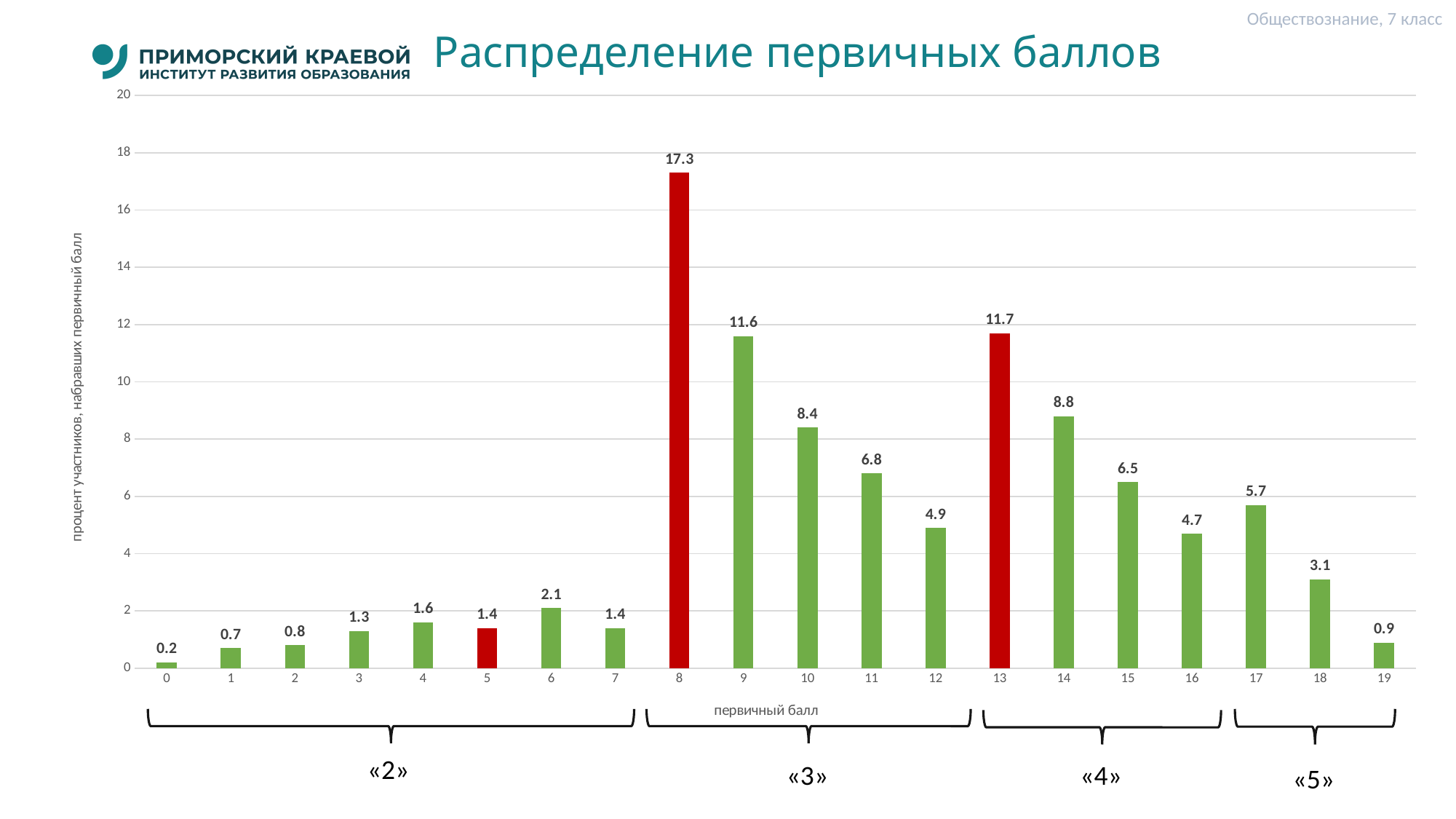
Which primary scores are shown with red bars? 5, 8 and 13 Is the value for primary score 10 greater or less than 8? greater Which is larger, the value for primary score 14 or for primary score 15? 14 How many primary score categories are shown on the x axis? 20 Which primary score has the lowest percentage of participants? 0 What is the value for primary score 17? 5.7 What is the value for primary score 13? 11.7 What kind of chart is shown on the slide? bar chart What is the difference between the values for primary scores 8 and 9? 5.7 Do the values rise or fall from primary score 13 to primary score 19? fall What is the value for primary score 8? 17.3 Which primary score has the highest percentage of participants? 8